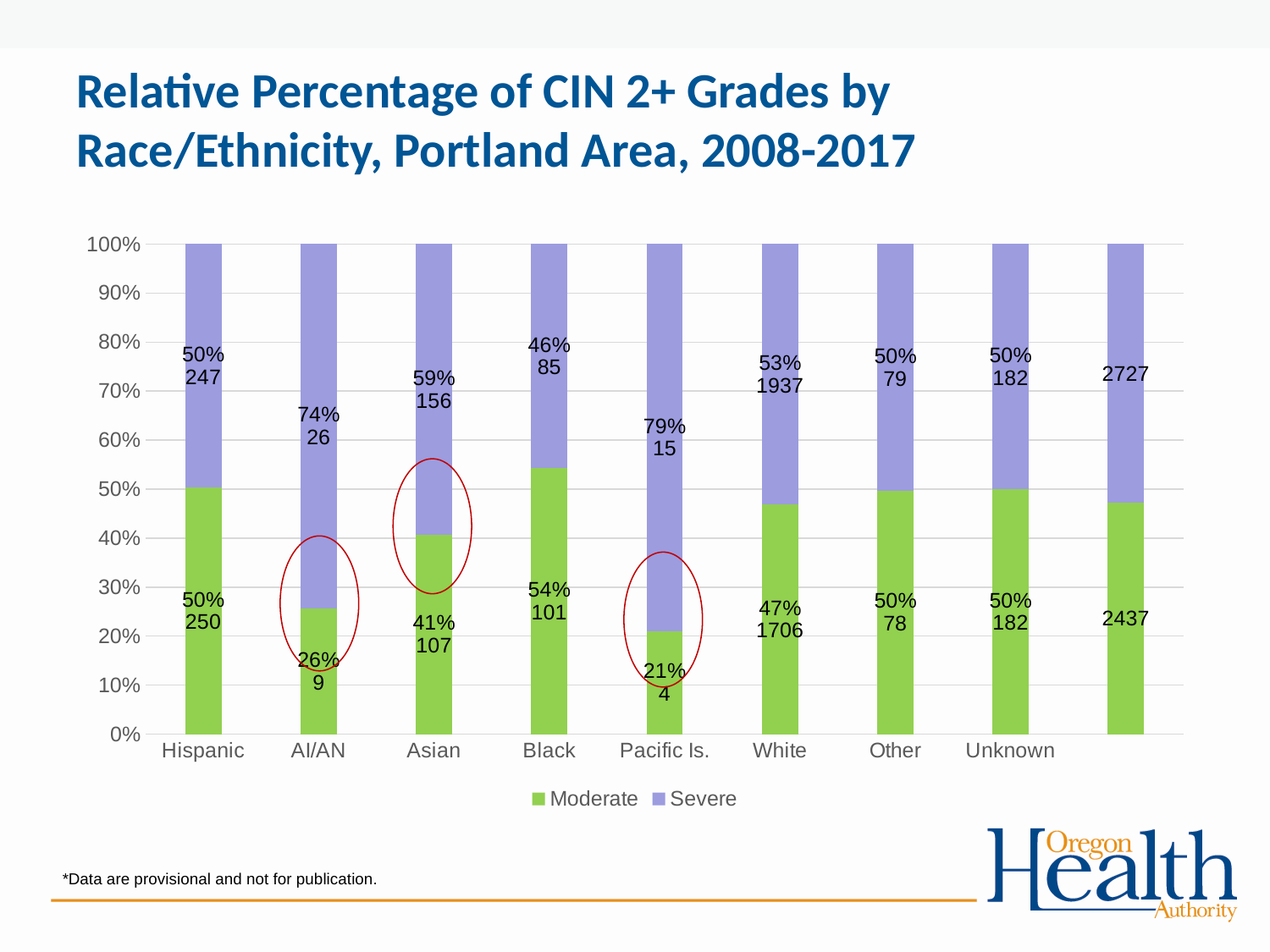
What is the count of Severe grades for White? 1937 Which race/ethnicity has the lowest Moderate percentage? Pacific Is. What kind of chart is shown on the slide? Stacked bar chart Is the Moderate share for Black greater or less than 50%? greater What is the count of Moderate grades for Pacific Is.? 4 What percentage of grades for AI/AN are Severe? 74% Which is larger for Asian: the Moderate count or the Severe count? Severe Which race/ethnicity has the highest Severe percentage? Pacific Is. What percentage of CIN 2+ grades for Hispanic are Moderate? 50% How many series does the legend list? 2 Which colour represents the Severe series in the legend? Purple For Black, how many more Moderate grades are there than Severe grades? 16